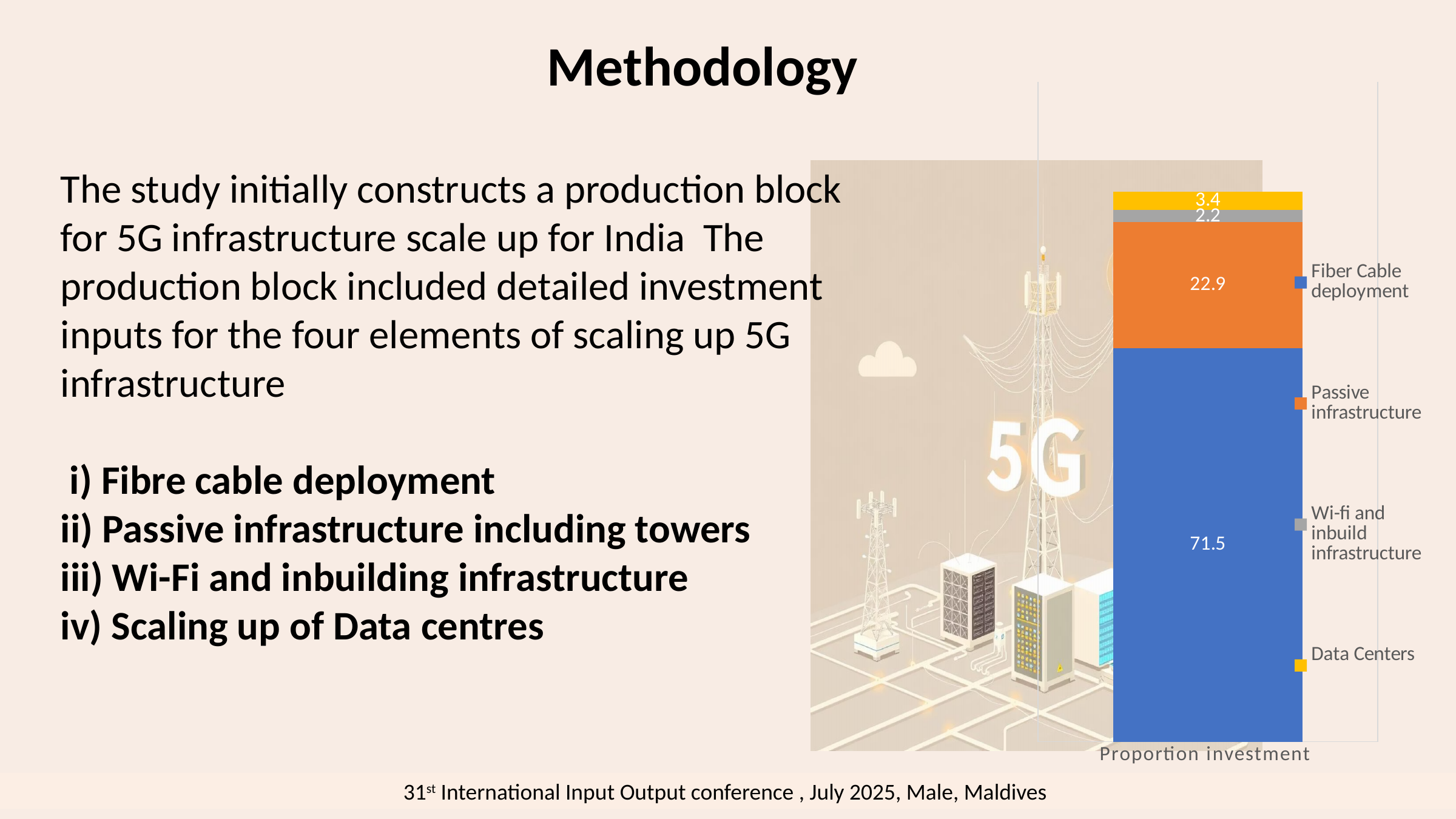
Which is larger, the value for Data Centers or the value for Wi-fi and inbuild infrastructure? Data Centers What is the difference between the Fiber Cable deployment value and the Passive infrastructure value? 48.6 What is the category label shown on the x axis of the chart? Proportion investment How many series does the legend list? 4 What is the value for Wi-fi and inbuild infrastructure in the Proportion investment bar? 2.2 Which series has the largest value in the Proportion investment bar? Fiber Cable deployment What kind of chart is shown on the slide? Stacked bar chart Which series has the smallest value in the Proportion investment bar? Wi-fi and inbuild infrastructure What is the value for Data Centers in the Proportion investment bar? 3.4 What is the value for Passive infrastructure in the Proportion investment bar? 22.9 What is the total of the Proportion investment stacked bar? 100.0 What is the value for Fiber Cable deployment in the Proportion investment bar? 71.5